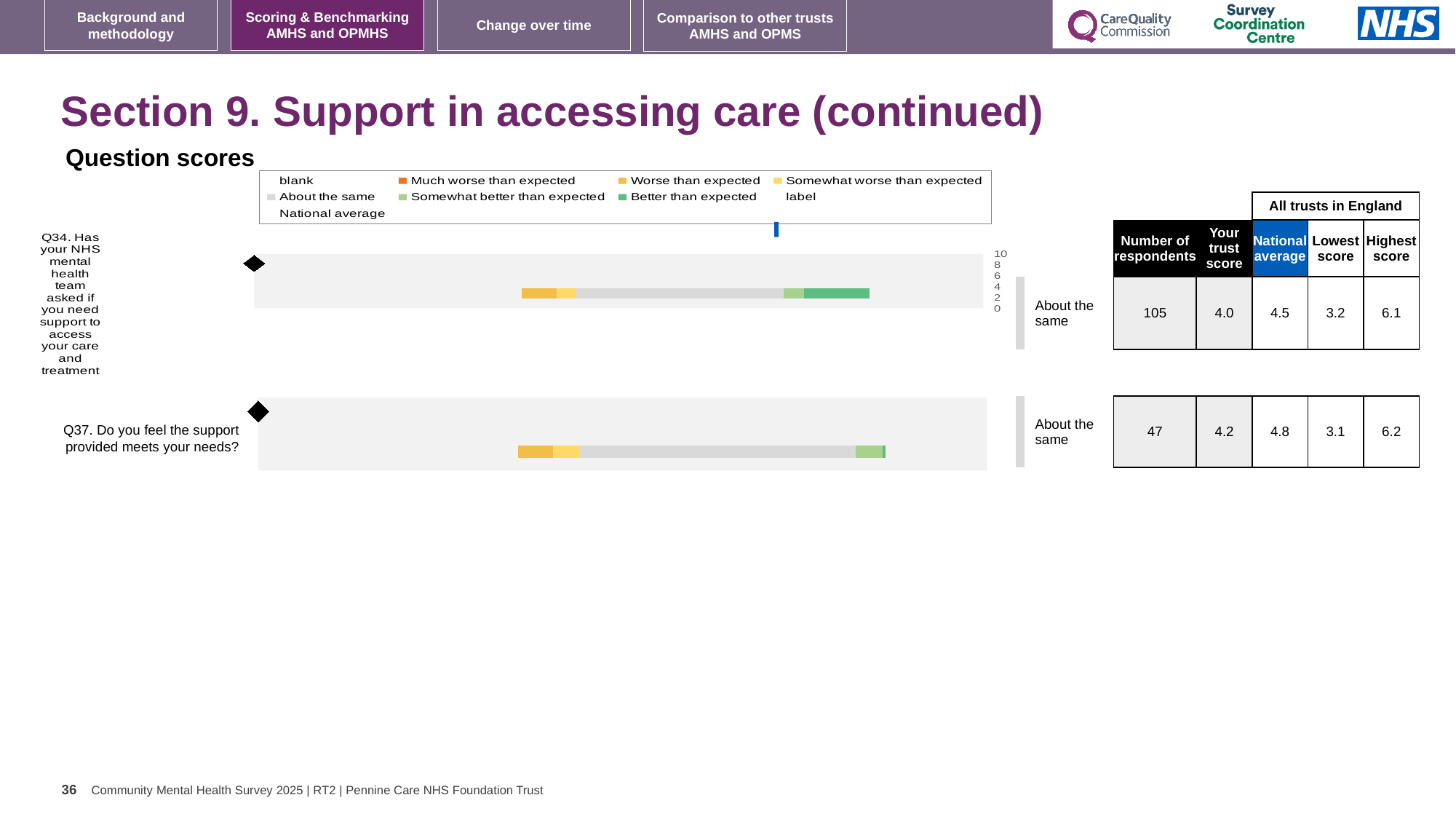
Which question has more respondents, Q34 or Q37? Q34 What benchmark category is shown next to the Q37 bar? About the same What is the highest score among all trusts in England for Q34? 6.1 What kind of chart is used to show the question scores on this slide? bar chart What is the difference between the highest score and the lowest score for Q37? 3.1 What is the difference between the national average and the trust score for Q34? 0.5 What is the national average score for Q37? 4.8 What is the trust score for Q37 (Do you feel the support provided meets your needs)? 4.2 How many questions are plotted in the question scores chart? 2 What is the trust score for Q34 (Has your NHS mental health team asked if you need support to access your care and treatment)? 4.0 How many respondents answered Q34? 105 Which question has the higher trust score, Q34 or Q37? Q37